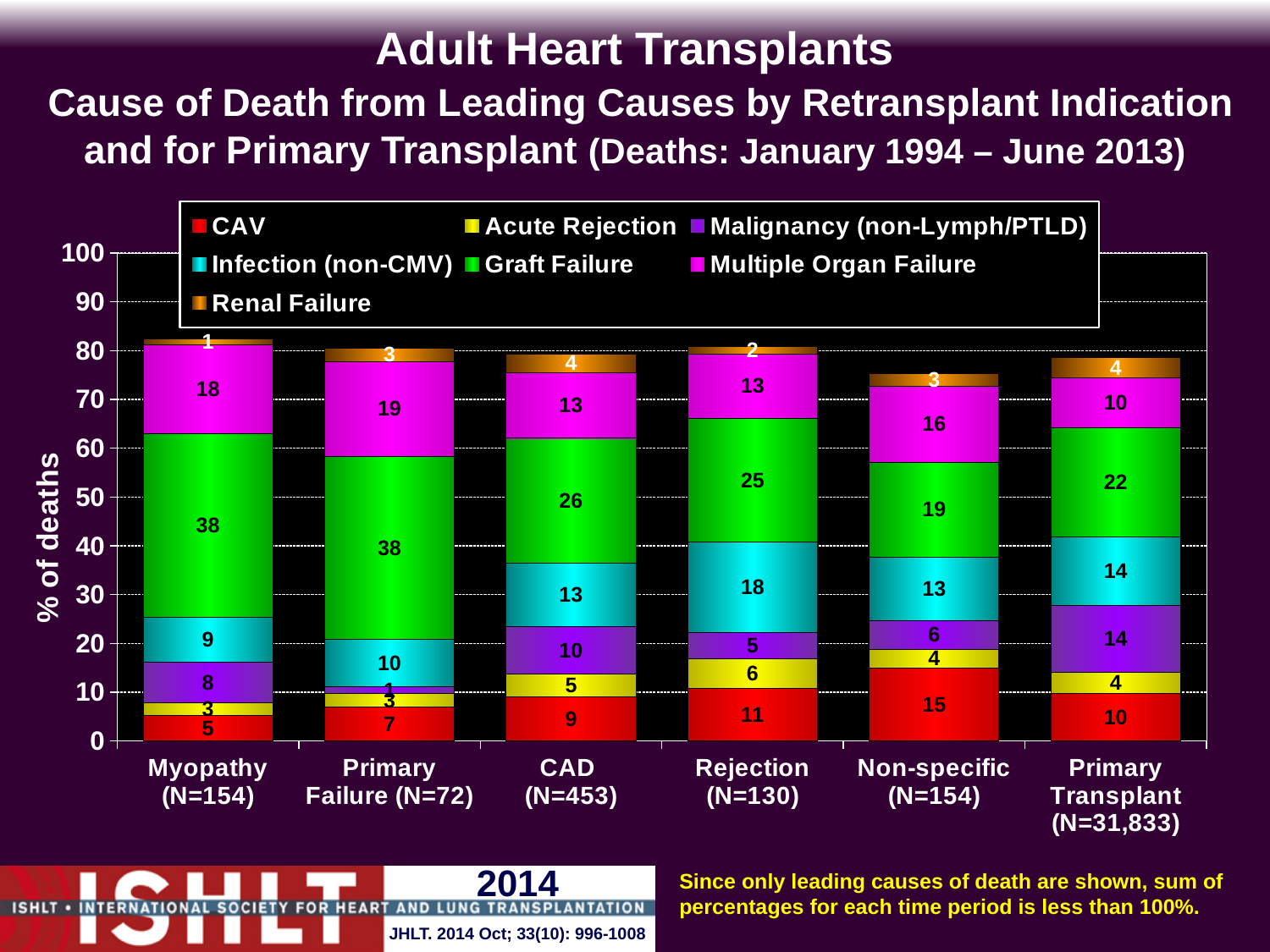
What is the Infection (non-CMV) percentage for Rejection (N=130)? 18 What is the total of the stacked bar for Rejection (N=130)? 80 Which category has the lowest Malignancy (non-Lymph/PTLD) percentage? Primary Failure (N=72) What type of chart is shown on the slide? Stacked bar chart What is the difference between the Graft Failure percentage for Myopathy (N=154) and for Primary Transplant (N=31,833)? 16 Which category has the highest CAV percentage? Non-specific (N=154) Which is larger: the Multiple Organ Failure percentage for Primary Failure (N=72) or for Primary Transplant (N=31,833)? Primary Failure (N=72) How many series does the legend list? 7 What is the CAV percentage for Non-specific (N=154)? 15 What is the Graft Failure percentage for CAD (N=453)? 26 How many retransplant indication / transplant categories are shown on the x axis? 6 What is the label on the y axis? % of deaths